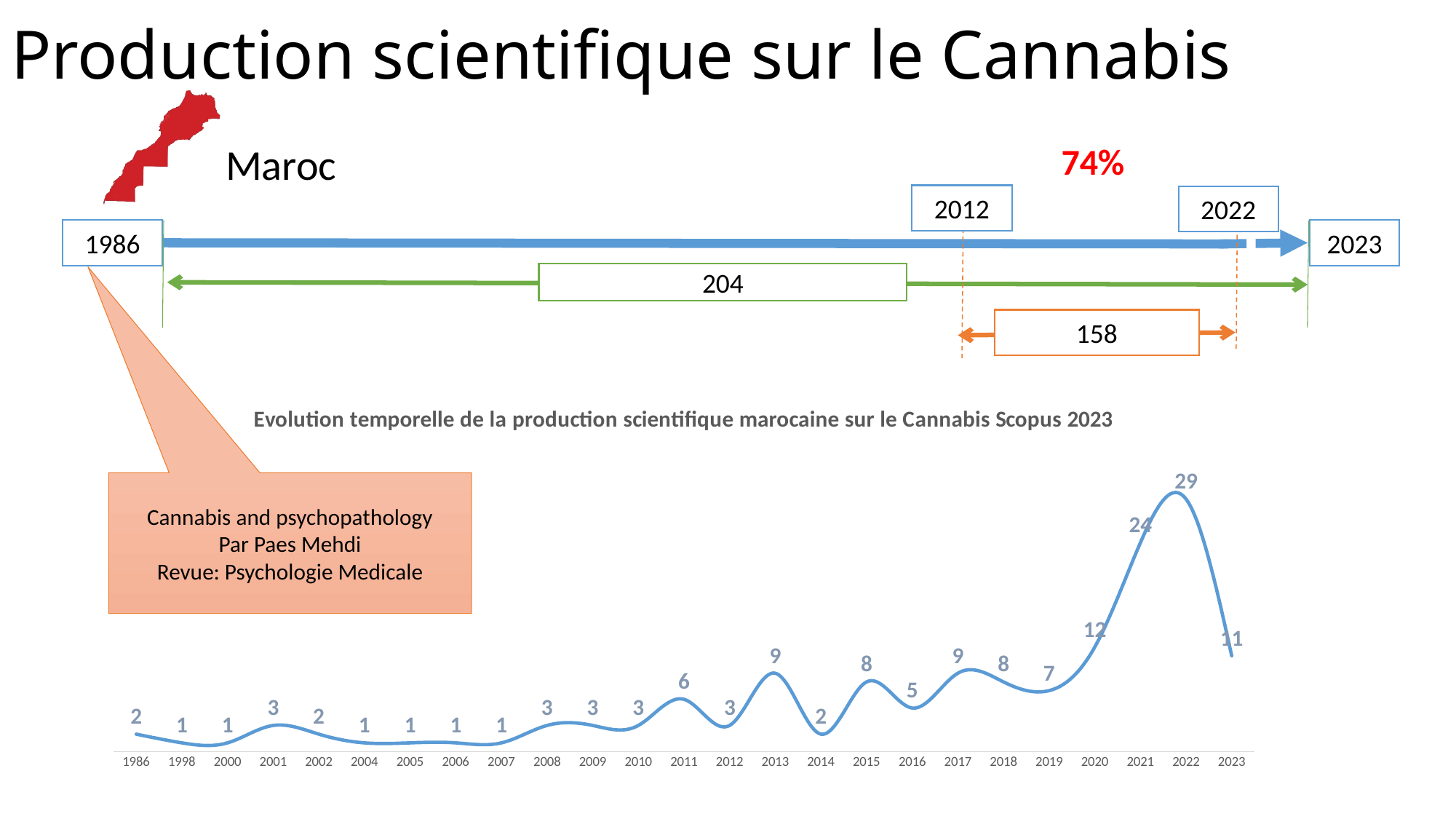
What kind of chart is shown at the bottom of the slide? Line chart What is the difference between the values for 2022 and 2021 in the line chart? 5 How many years are plotted on the x axis of the line chart? 25 What is the value for 2021 in the line chart? 24 What is the value for 2023 in the line chart? 11 What is the value for 1986 in the line chart? 2 Which year has the highest value in the line chart? 2022 What is the value for 2022 in the line chart? 29 What is the difference between the values for 2022 and 2023 in the line chart? 18 What is the value for 2013 in the line chart? 9 Which year has the larger value in the line chart, 2015 or 2016? 2015 Do the values in the line chart rise or fall from 2019 to 2022? Rise